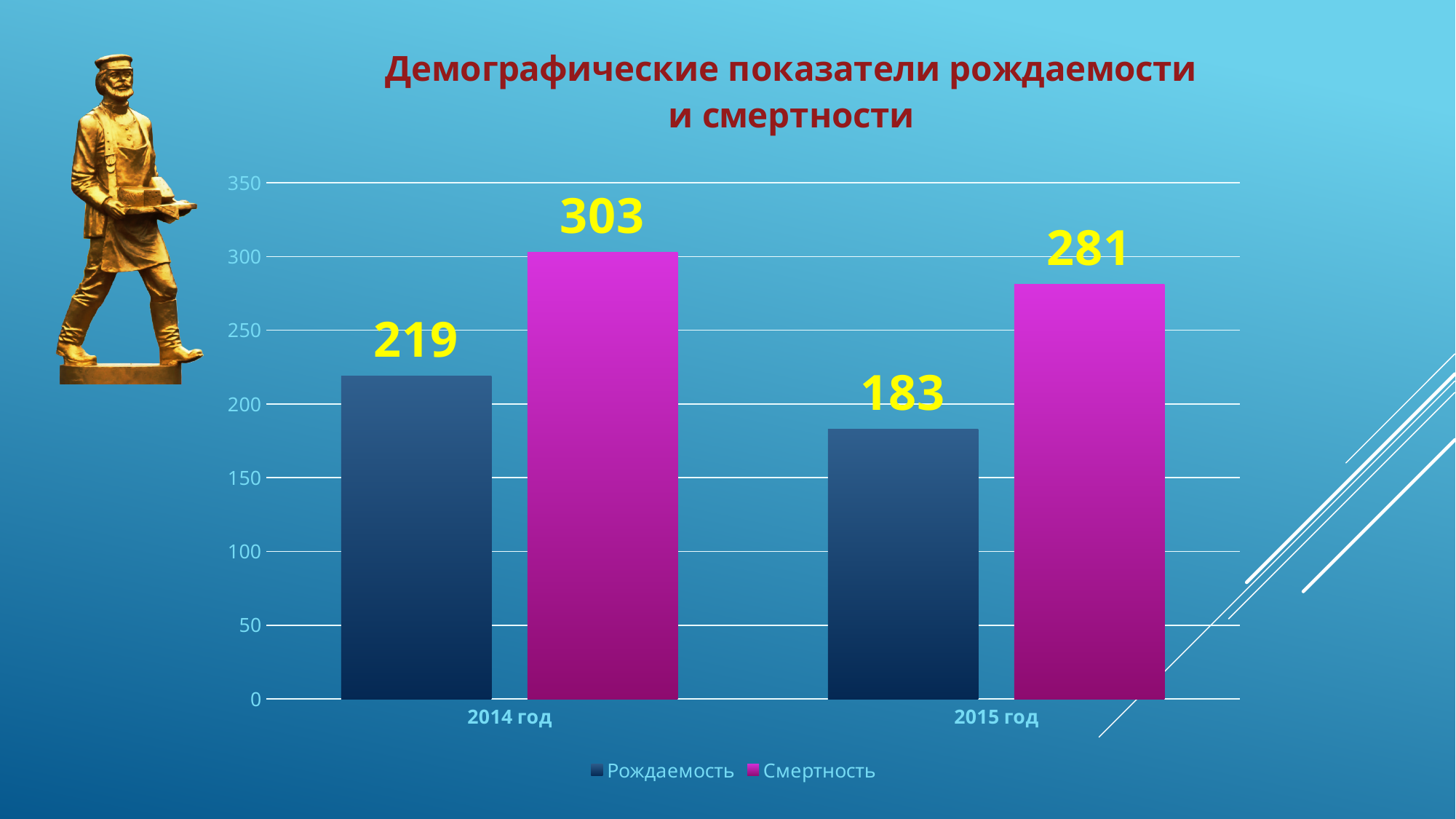
What kind of chart is shown on the slide? Bar chart What is the value for Смертность in 2014 год? 303 Which bar has the lowest value on the chart? Рождаемость, 2015 год What is the difference between Смертность and Рождаемость in 2015 год? 98 Does the value for Рождаемость rise or fall from 2014 год to 2015 год? Fall What is the value for Рождаемость in 2015 год? 183 What is the value for Рождаемость in 2014 год? 219 Which is larger in 2015 год, Рождаемость or Смертность? Смертность How many series does the legend list? 2 Which bar has the highest value on the chart? Смертность, 2014 год What is the difference between Смертность and Рождаемость in 2014 год? 84 What is the value for Смертность in 2015 год? 281